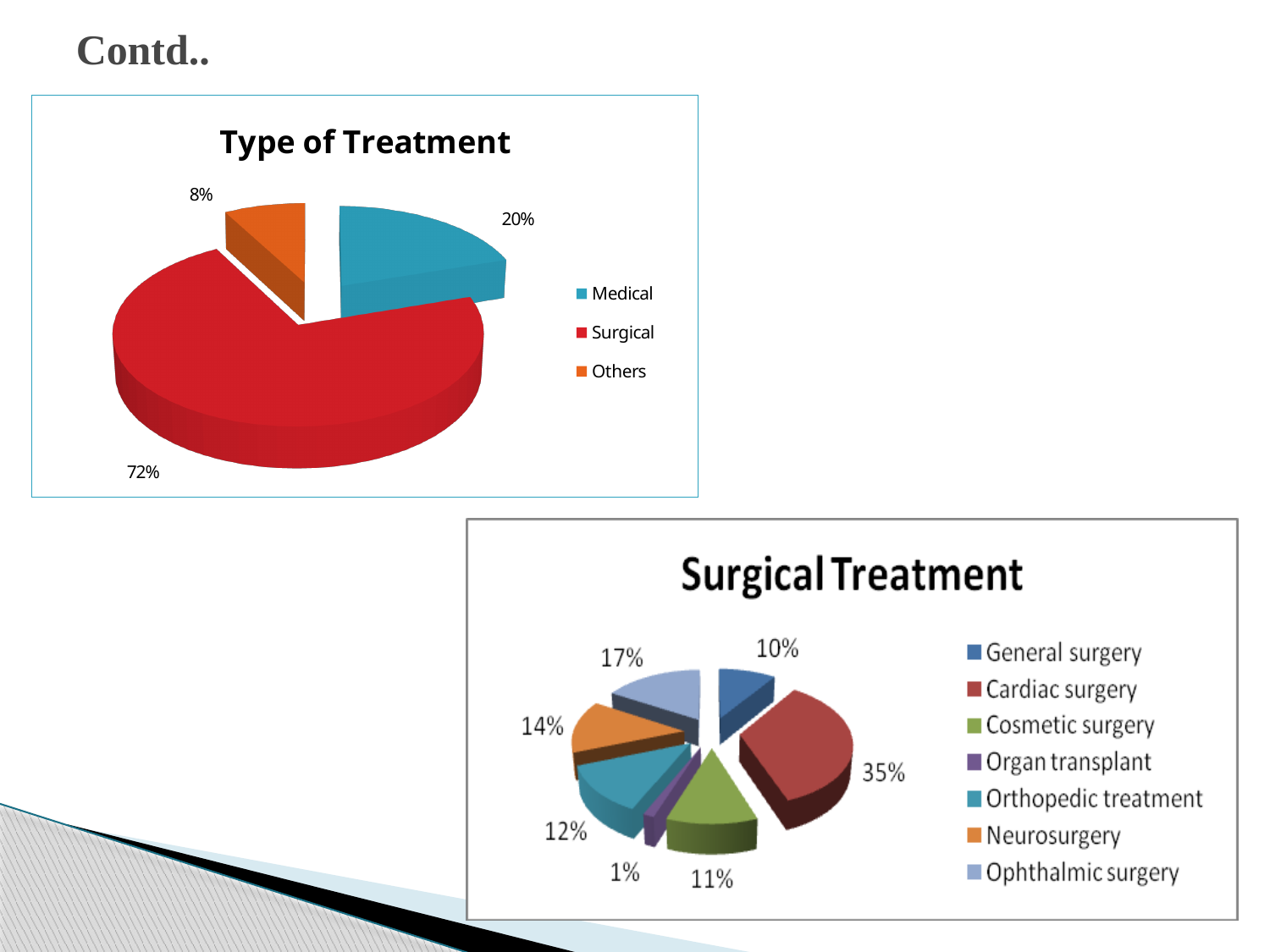
In the 'Type of Treatment' chart, what is the difference between the Surgical and Medical shares? 52% In the 'Surgical Treatment' chart, what share does Ophthalmic surgery have? 17% What kind of chart is the 'Surgical Treatment' chart? Pie chart In the 'Surgical Treatment' chart, which category has the smallest share? Organ transplant In the 'Surgical Treatment' chart, what share does Cardiac surgery have? 35% In the 'Surgical Treatment' chart, what is the difference between the Cardiac surgery and General surgery shares? 25% In the 'Type of Treatment' chart, which category has the smallest share? Others In the 'Surgical Treatment' chart, which is larger: Neurosurgery or Orthopedic treatment? Neurosurgery In the 'Type of Treatment' chart, what share does Surgical have? 72% In the 'Type of Treatment' chart, what share does Others have? 8% In the 'Surgical Treatment' chart, how many categories does the legend list? 7 In the 'Type of Treatment' chart, how many categories does the legend list? 3